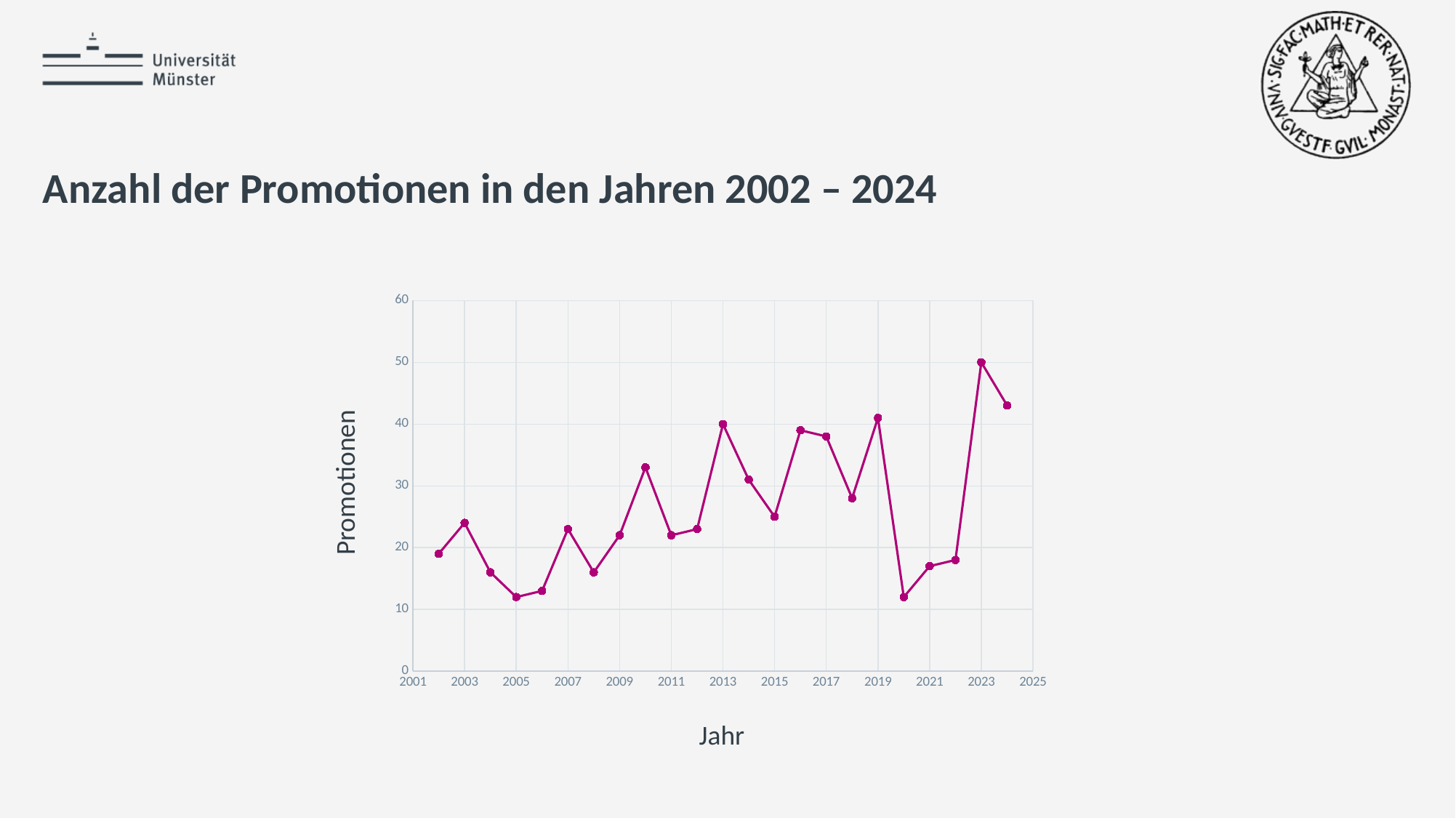
What is the value for 2023? 50 Which year has the larger value, 2019 or 2020? 2019 What kind of chart is shown on the slide? line chart What is the value for 2013? 40 Do the values rise or fall from 2020 to 2023? rise What is the label of the vertical axis? Promotionen How many data points are plotted on the line? 23 Is the value for 2020 greater or less than 20? less Is the value for 2005 greater or less than 20? less In which year is the number of Promotionen highest? 2023 What is the title of the chart on the slide? Anzahl der Promotionen in den Jahren 2002 – 2024